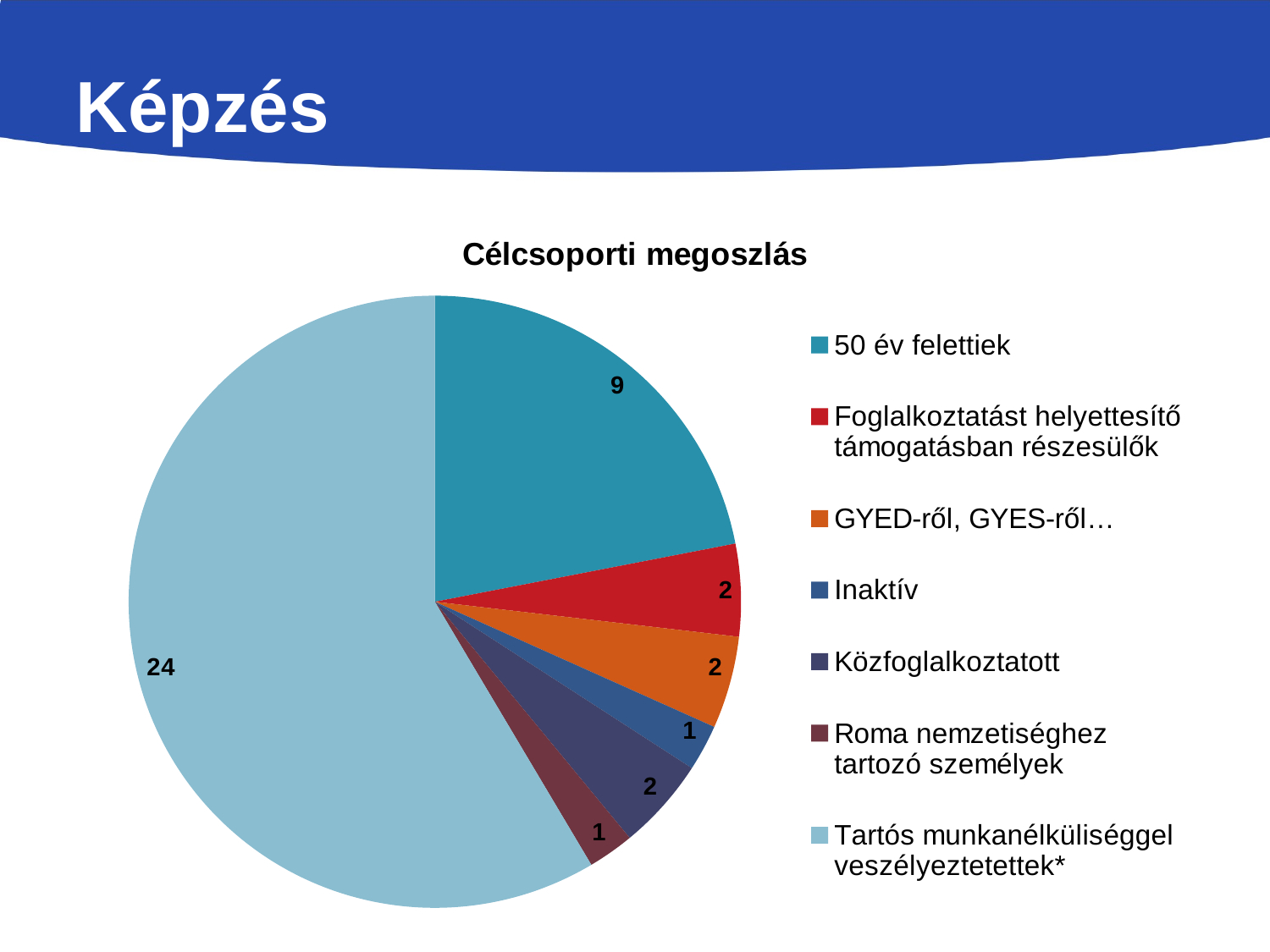
Which is larger, the '50 év felettiek' slice or the 'GYED-ről, GYES-ről…' slice? 50 év felettiek What is the value for the '50 év felettiek' slice? 9 What is the value for the 'Tartós munkanélküliséggel veszélyeztetettek*' slice? 24 Which categories have the smallest value in the pie? Inaktív and Roma nemzetiséghez tartozó személyek What is the difference between the 'Tartós munkanélküliséggel veszélyeztetettek*' slice and the '50 év felettiek' slice? 15 What is the title of the chart? Célcsoporti megoszlás What type of chart is shown on the slide? Pie chart What is the value for the 'Inaktív' slice? 1 Which category has the largest slice of the pie? Tartós munkanélküliséggel veszélyeztetettek* What is the value for the 'Közfoglalkoztatott' slice? 2 What is the total of all the slice values in the pie chart? 41 How many categories does the pie chart have? 7